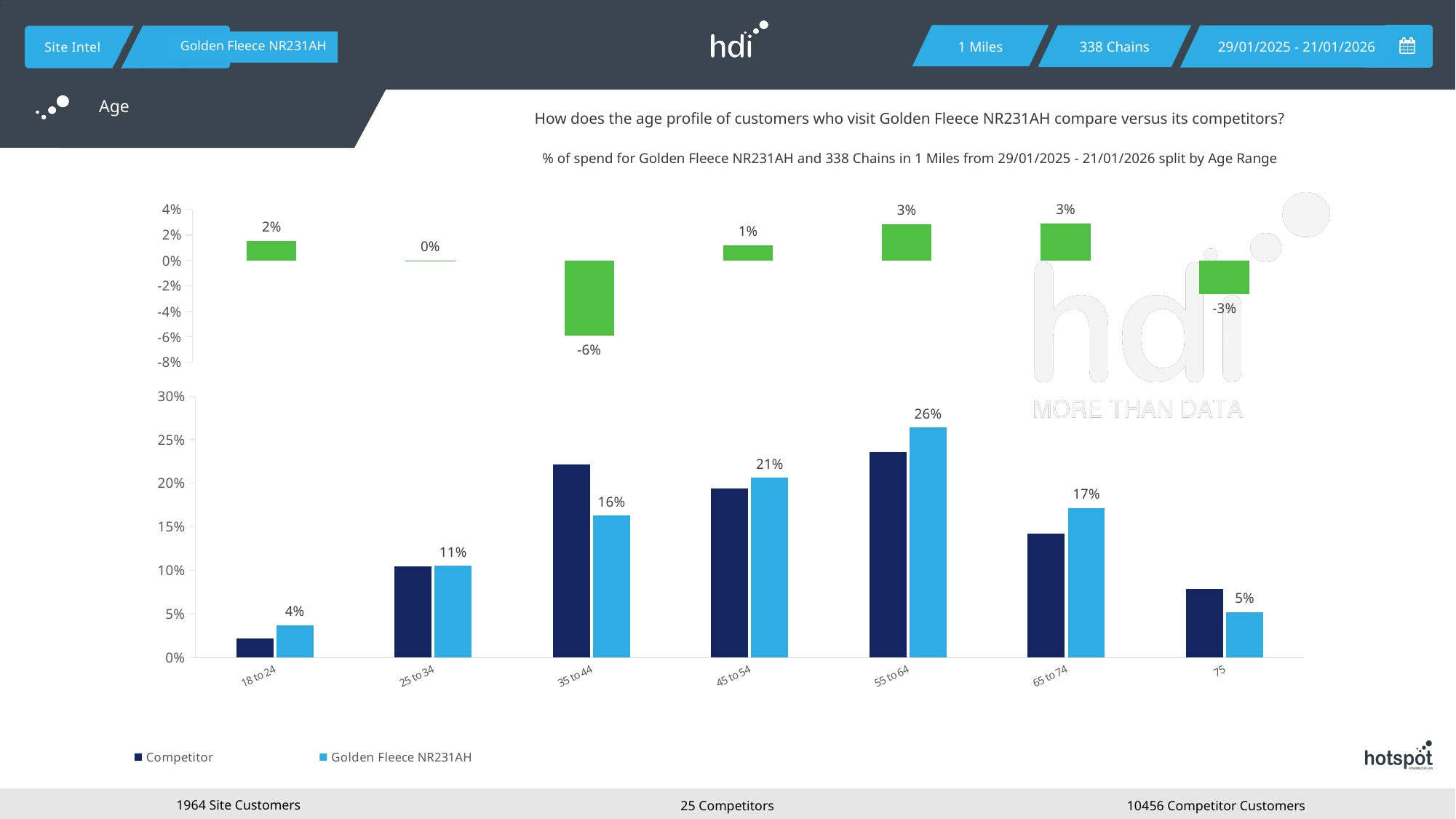
In the bottom chart, is the Competitor value for the 75 age range greater or less than 10%? less In the bottom chart, what is the value for Golden Fleece NR231AH in the 55 to 64 age range? 26% In the top chart, what is the value shown for the 35 to 44 age range? -6% How many age range categories are shown on the x axis of the bottom chart? 7 In the top chart, what is the value shown for the 65 to 74 age range? 3% What kind of chart is the bottom chart? Bar chart In the bottom chart, which age range has the highest value for Golden Fleece NR231AH? 55 to 64 In the bottom chart, is the Competitor value for 55 to 64 greater or less than 20%? greater In the top chart, which age range has the lowest value? 35 to 44 In the bottom chart, what is the difference between the Golden Fleece NR231AH values for 55 to 64 and 18 to 24? 22% How many series does the legend of the bottom chart list? 2 In the bottom chart, for the 35 to 44 age range, which series has the larger value: Competitor or Golden Fleece NR231AH? Competitor